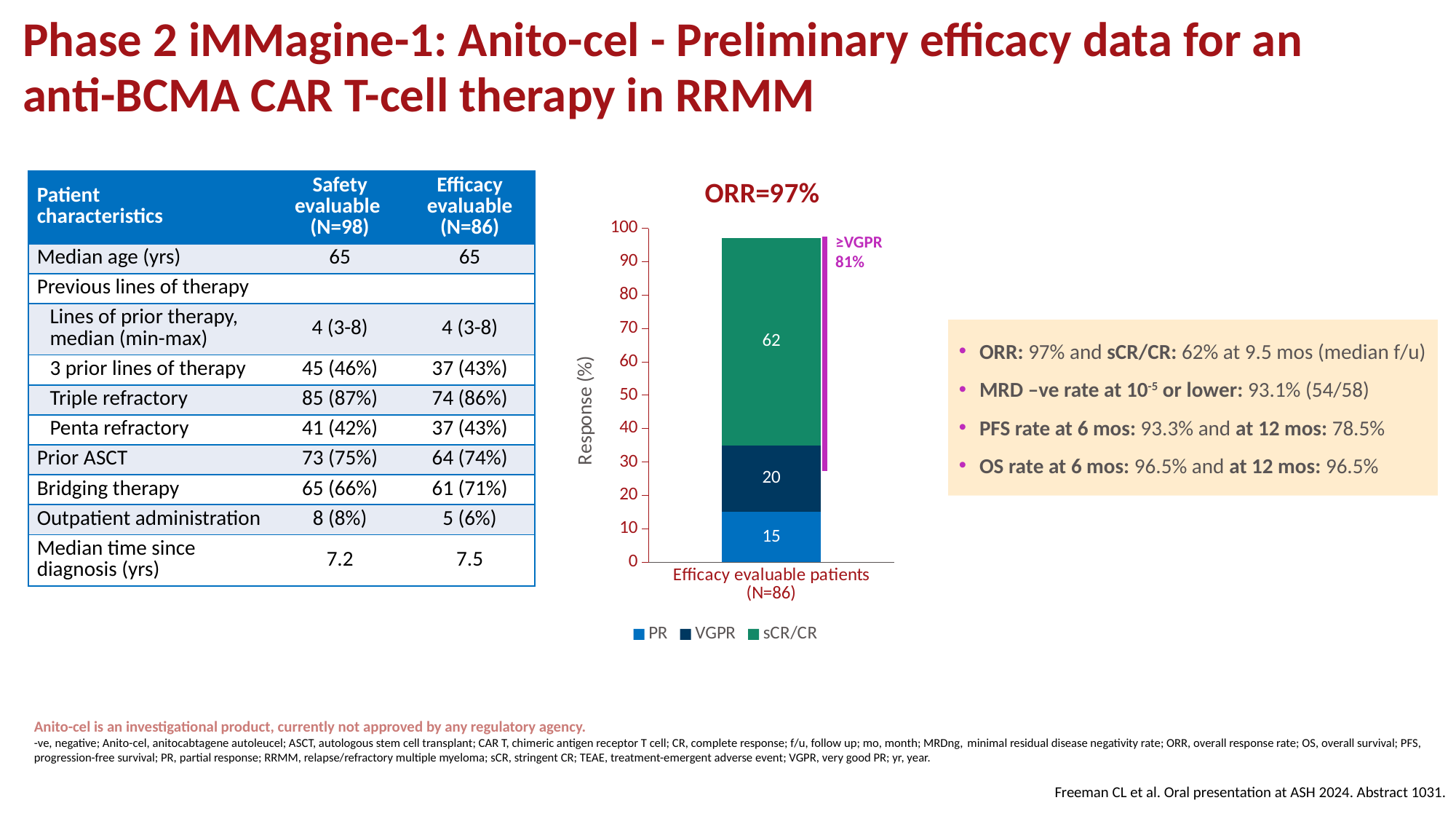
How many series does the legend list? 3 What is the difference between the sCR/CR and VGPR segment values? 42 What is the total of the stacked bar (PR + VGPR + sCR/CR)? 97 What is the ORR shown above the chart? ORR=97% What is the value of the sCR/CR segment in the stacked bar? 62 Which response category has the largest segment in the stacked bar? sCR/CR What is the value of the PR segment in the stacked bar? 15 What is the ≥VGPR rate annotated beside the bar? 81% Which segment is larger, VGPR or PR? VGPR What is the value of the VGPR segment in the stacked bar? 20 Which response category has the smallest segment in the stacked bar? PR What type of chart is shown on the slide? Stacked bar chart